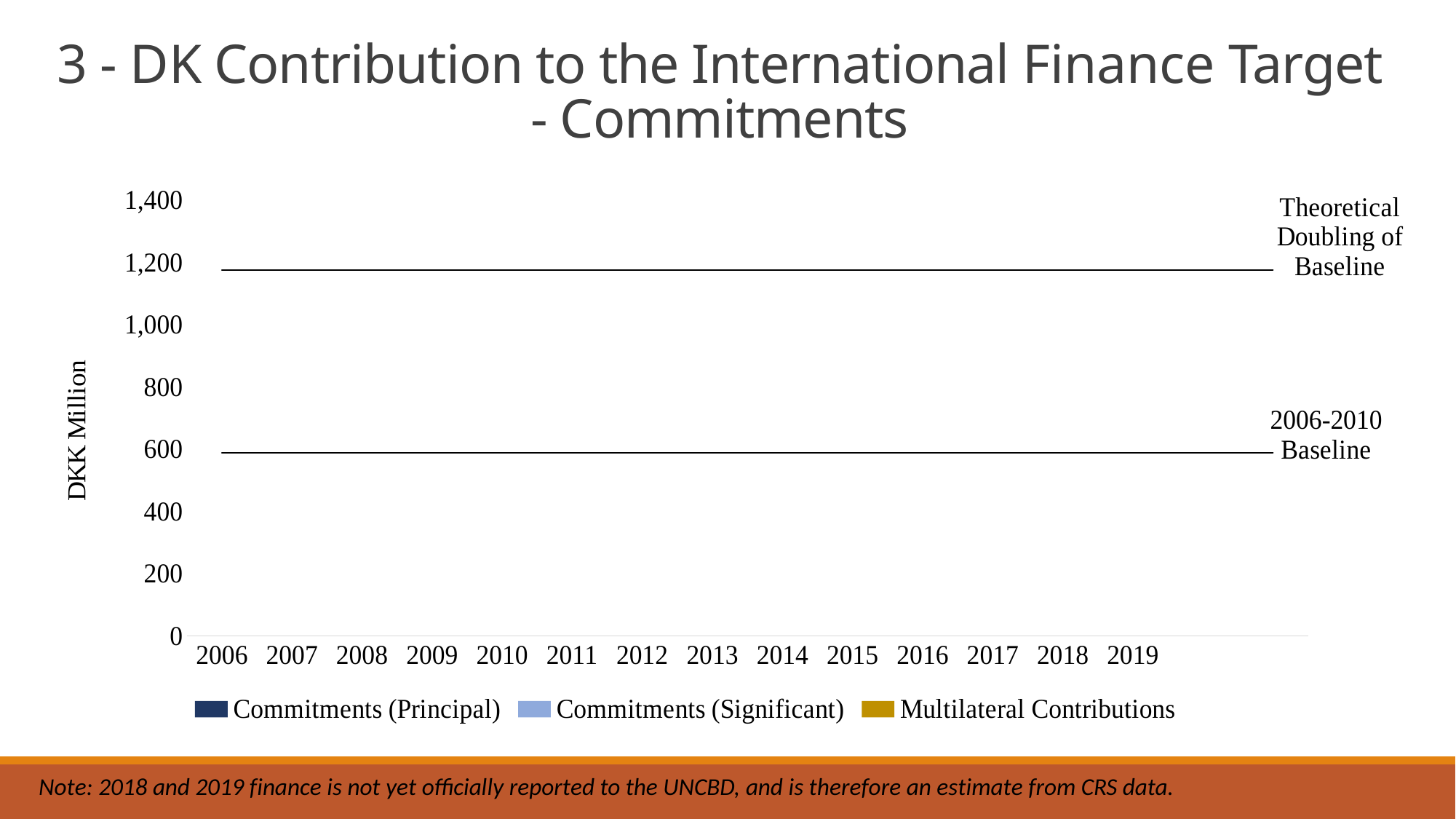
How many years are shown along the x axis of the chart? 14 What is the maximum value shown on the vertical axis of the chart? 1,400 How many series does the chart legend list? 3 What is the label on the vertical axis of the chart? DKK Million What is the first year shown on the x axis of the chart? 2006 Is the 'Theoretical Doubling of Baseline' line higher or lower than the '2006-2010 Baseline' line? higher Which legend entry is shown in dark blue? Commitments (Principal) What is the last year shown on the x axis of the chart? 2019